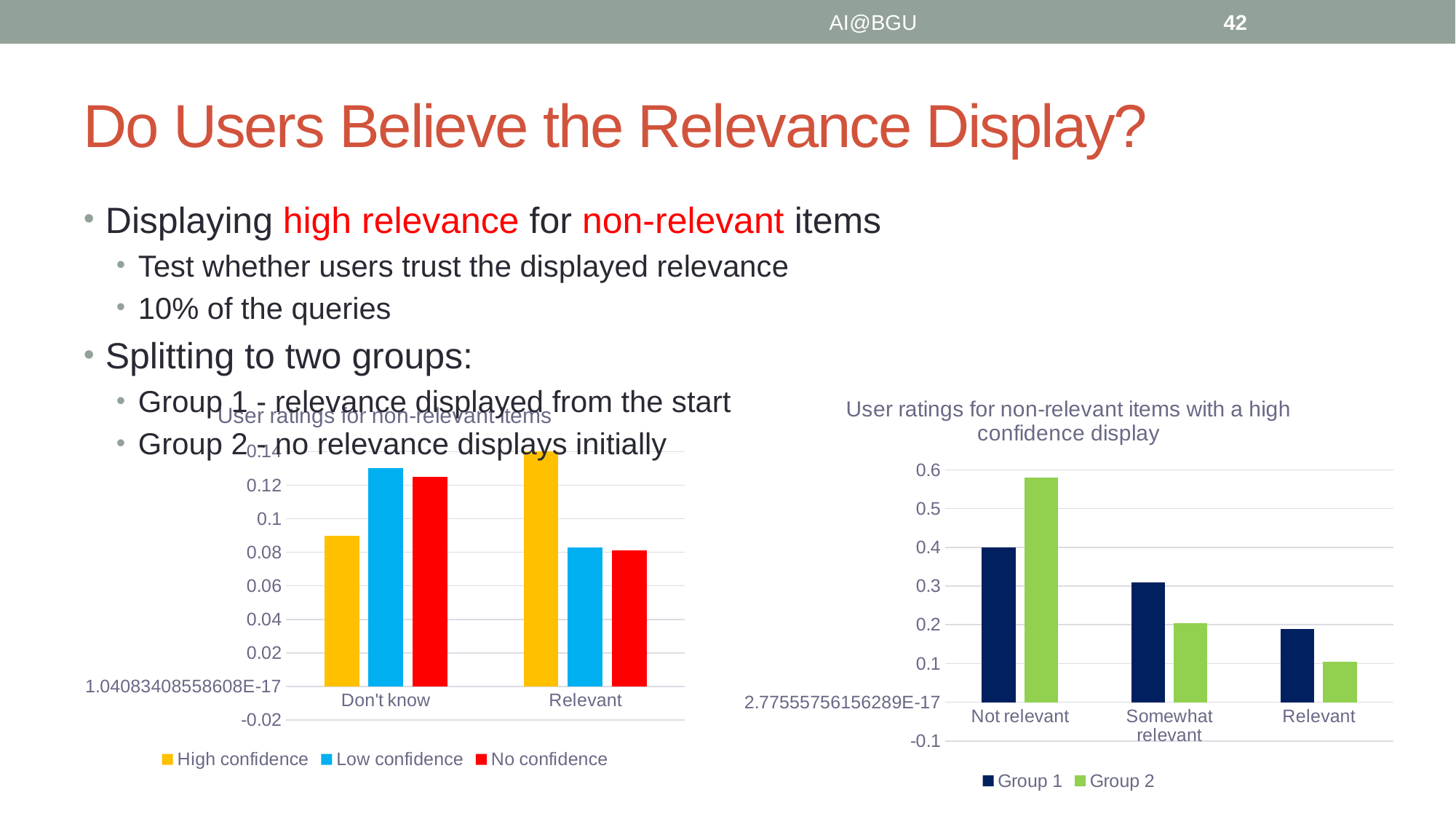
In the chart titled 'User ratings for non-relevant items with a high confidence display', how many series does the legend list? 2 In the chart titled 'User ratings for non-relevant items with a high confidence display', which series has the higher value for 'Not relevant'? Group 2 In the chart titled 'User ratings for non-relevant items with a high confidence display', how many categories are shown on the x axis? 3 In the chart titled 'User ratings for non-relevant items', which is larger for 'Don't know': High confidence or Low confidence? Low confidence In the chart titled 'User ratings for non-relevant items', is the High confidence value for 'Don't know' greater or less than 0.1? less What kind of chart is the one on the left of the slide? bar chart In the chart titled 'User ratings for non-relevant items with a high confidence display', is the Group 1 value for 'Relevant' greater or less than 0.3? less In the chart titled 'User ratings for non-relevant items', how many series does the legend list? 3 In the chart titled 'User ratings for non-relevant items with a high confidence display', is the Group 2 value for 'Not relevant' greater or less than 0.5? greater In the chart titled 'User ratings for non-relevant items', which series has the highest value for 'Relevant'? High confidence In the chart titled 'User ratings for non-relevant items with a high confidence display', which category has the lowest Group 2 value? Relevant In the chart titled 'User ratings for non-relevant items with a high confidence display', do the Group 1 values rise or fall from 'Not relevant' to 'Relevant'? fall